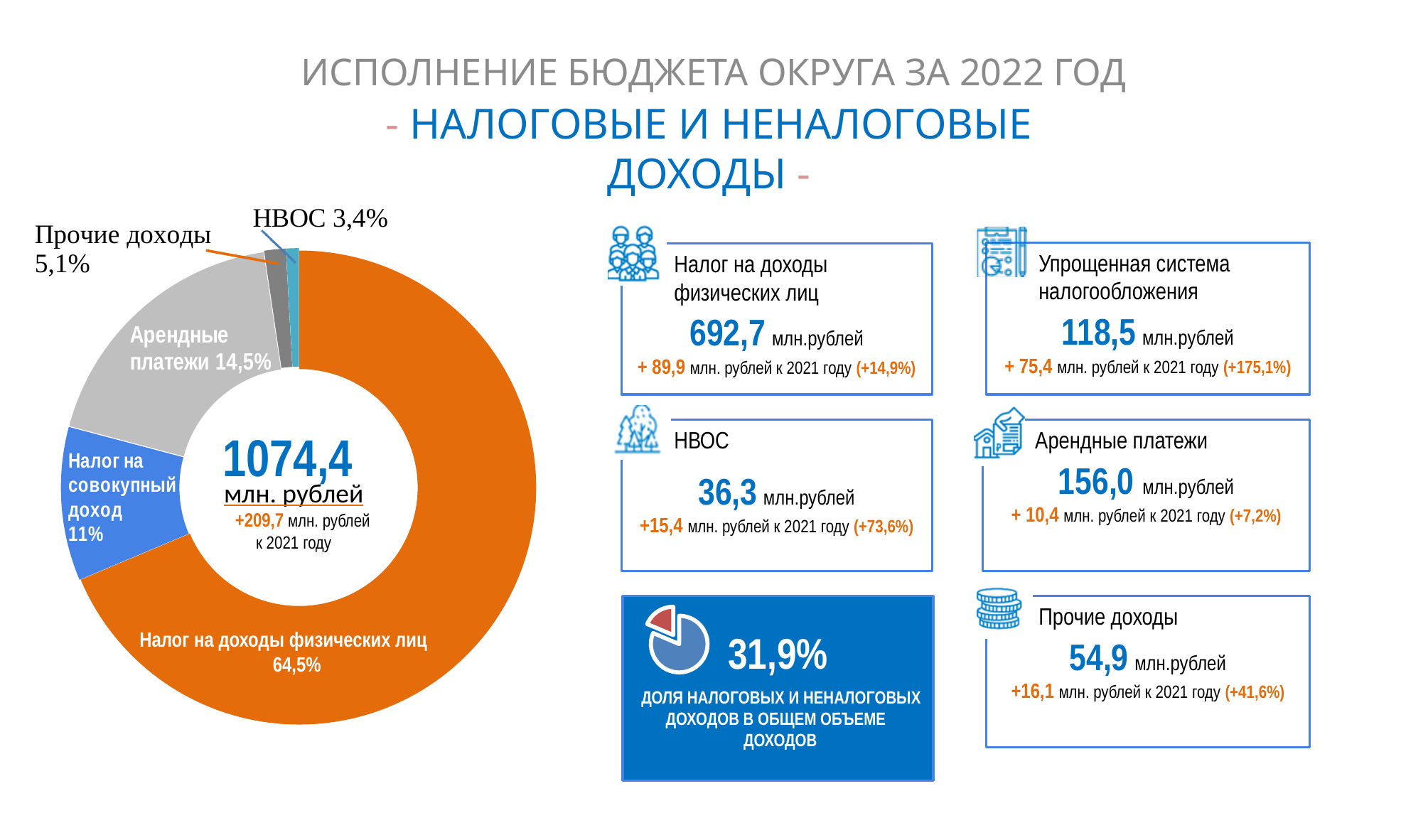
Which slice of the donut chart is the largest? Налог на доходы физических лиц What share of the donut chart is labelled "Налог на совокупный доход"? 11% What share of the donut chart is labelled "Налог на доходы физических лиц"? 64,5% What total value is printed in the centre of the donut chart? 1074,4 млн. рублей What is the difference in percentage points between the "Арендные платежи" slice and the "Прочие доходы" slice in the donut chart? 9,4 What kind of chart is shown on the left of the slide? Pie (donut) chart What share of the donut chart is labelled "Арендные платежи"? 14,5% Which slice of the donut chart is the smallest? НВОС How many slices does the donut chart have? 5 In the donut chart, which is larger: the share for "Арендные платежи" or the share for "Налог на совокупный доход"? Арендные платежи